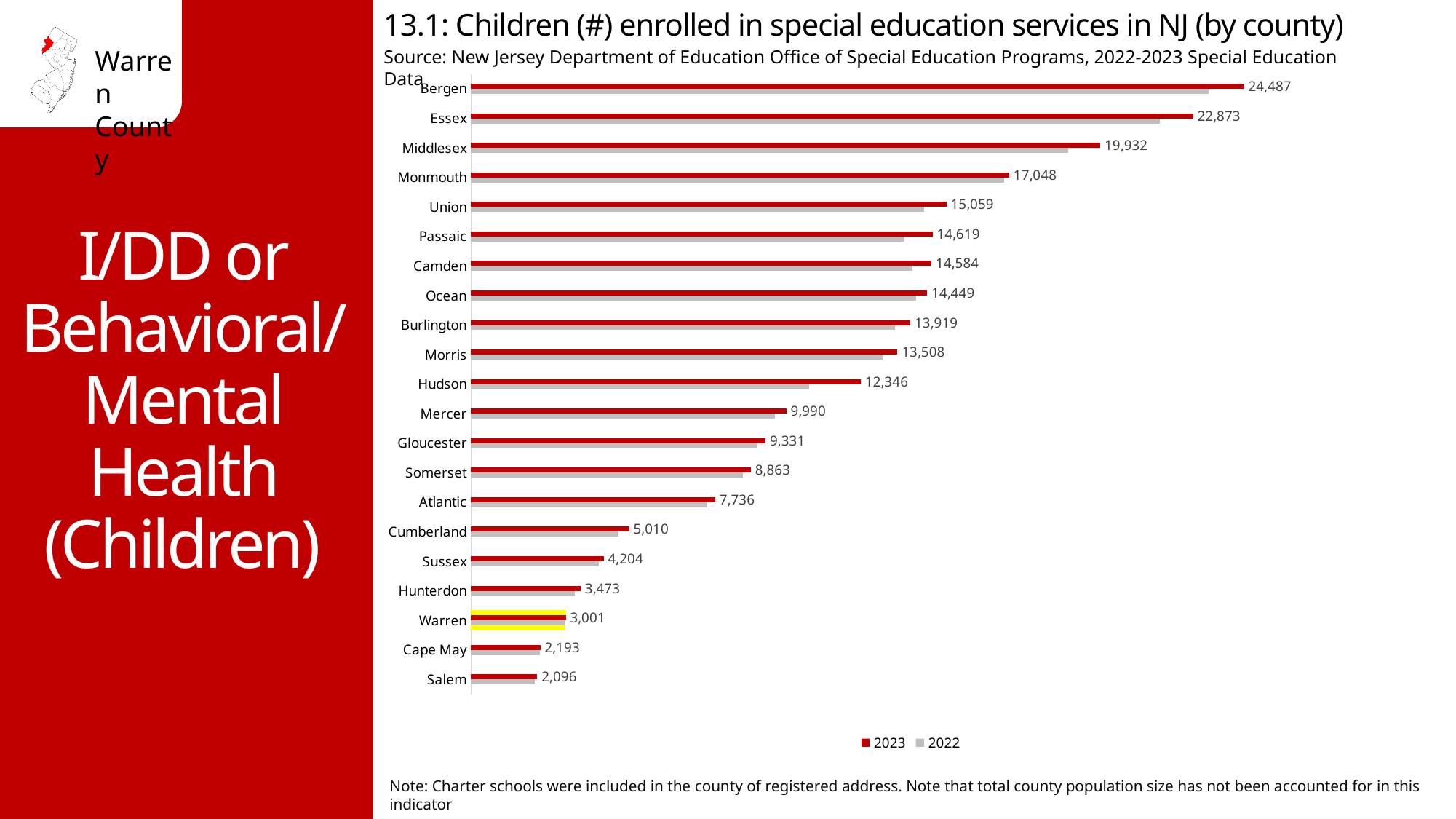
What is the 2023 value for Warren county? 3,001 Which county has the lowest 2023 value? Salem Which series is shown in red in the legend? 2023 What is the difference between the 2023 values for Bergen and Essex? 1,614 Which county has the highest 2023 value? Bergen What is the 2023 value for Bergen county? 24,487 For Hudson county, is the 2023 bar longer or shorter than the 2022 bar? Longer How many series does the legend list? 2 How many counties are shown in the chart? 21 What is the 2023 value for Hudson county? 12,346 Which county has the larger 2023 value, Hunterdon or Sussex? Sussex What kind of chart is shown on the slide? Bar chart